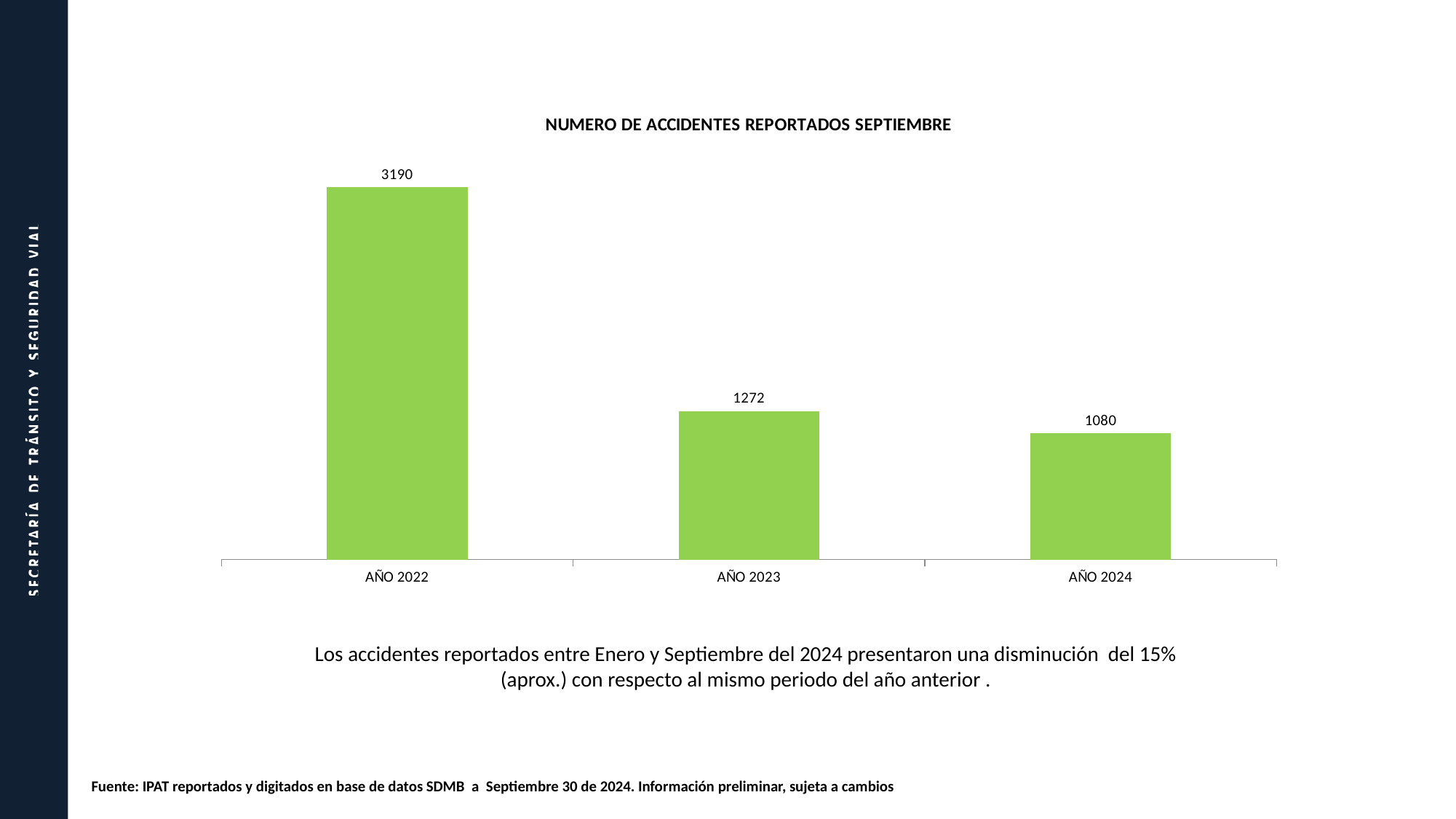
How many categories are shown in the chart? 3 What is the value for AÑO 2022? 3190 What is the value for AÑO 2023? 1272 What is the title of the chart? NUMERO DE ACCIDENTES REPORTADOS SEPTIEMBRE What is the difference between the values for AÑO 2022 and AÑO 2023? 1918 What is the difference between the values for AÑO 2023 and AÑO 2024? 192 Do the values rise or fall from AÑO 2022 to AÑO 2024? Fall Which is larger, the value for AÑO 2023 or AÑO 2024? AÑO 2023 Which year has the lowest number of reported accidents? AÑO 2024 Which year has the highest number of reported accidents? AÑO 2022 What is the value for AÑO 2024? 1080 What kind of chart is shown on the slide? Bar chart